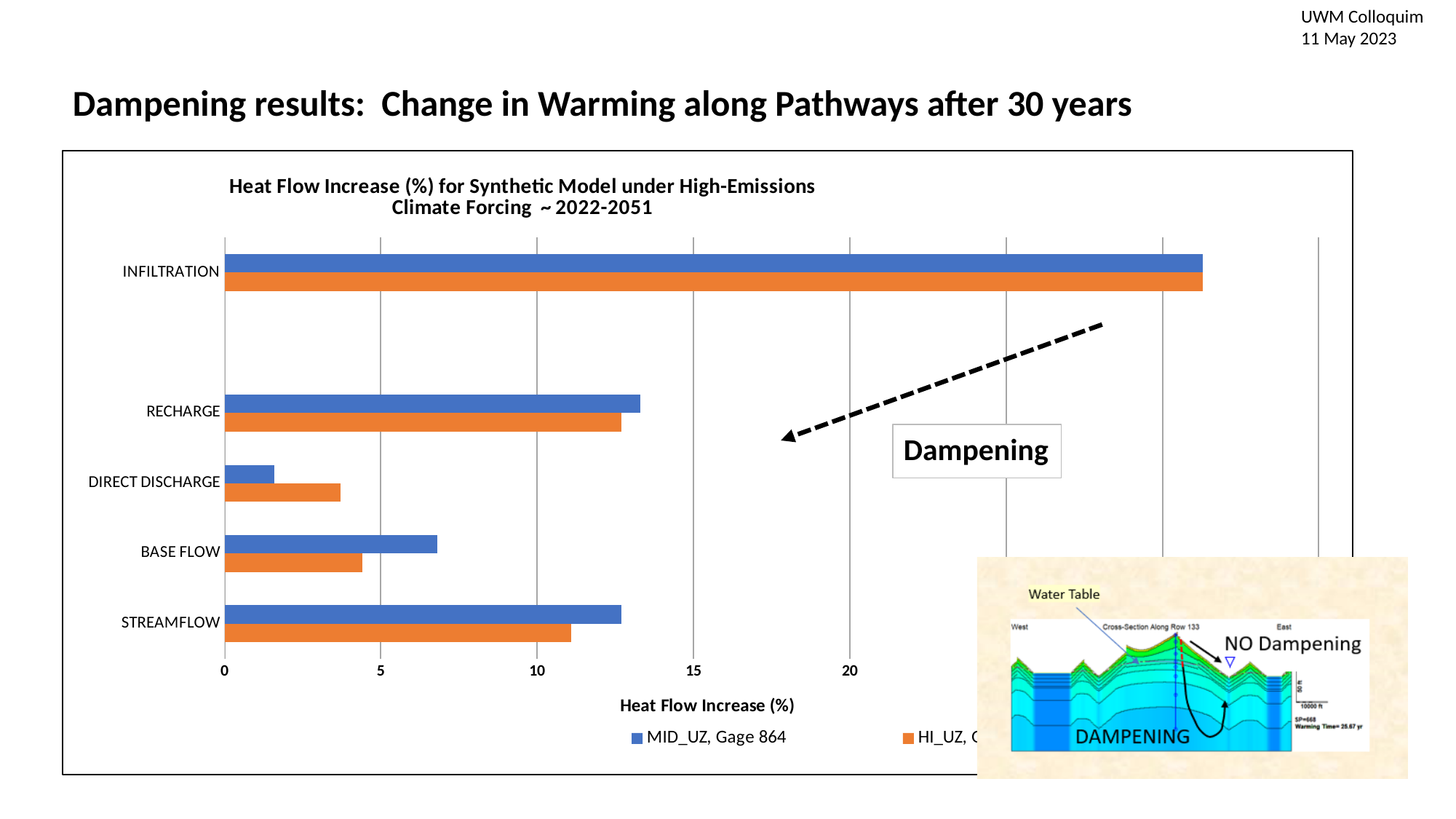
What kind of chart is shown on the slide? Bar chart What colour are the bars for the MID_UZ, Gage 864 series? Blue Is the MID_UZ, Gage 864 value for BASE FLOW greater or less than 10? less Which category has the highest heat flow increase for the MID_UZ, Gage 864 series? INFILTRATION Is the MID_UZ, Gage 864 value for INFILTRATION greater or less than 20? greater What is the label of the chart's horizontal axis? Heat Flow Increase (%) How many pathway categories are plotted on the chart? 5 Is the MID_UZ, Gage 864 value for RECHARGE greater or less than 10? greater For DIRECT DISCHARGE, which series has the larger heat flow increase, the blue MID_UZ, Gage 864 series or the orange series? The orange series Which category has the lowest heat flow increase for the MID_UZ, Gage 864 series? DIRECT DISCHARGE How many series does the chart's legend list? 2 For BASE FLOW, which series has the larger heat flow increase, MID_UZ, Gage 864 or the orange series? MID_UZ, Gage 864